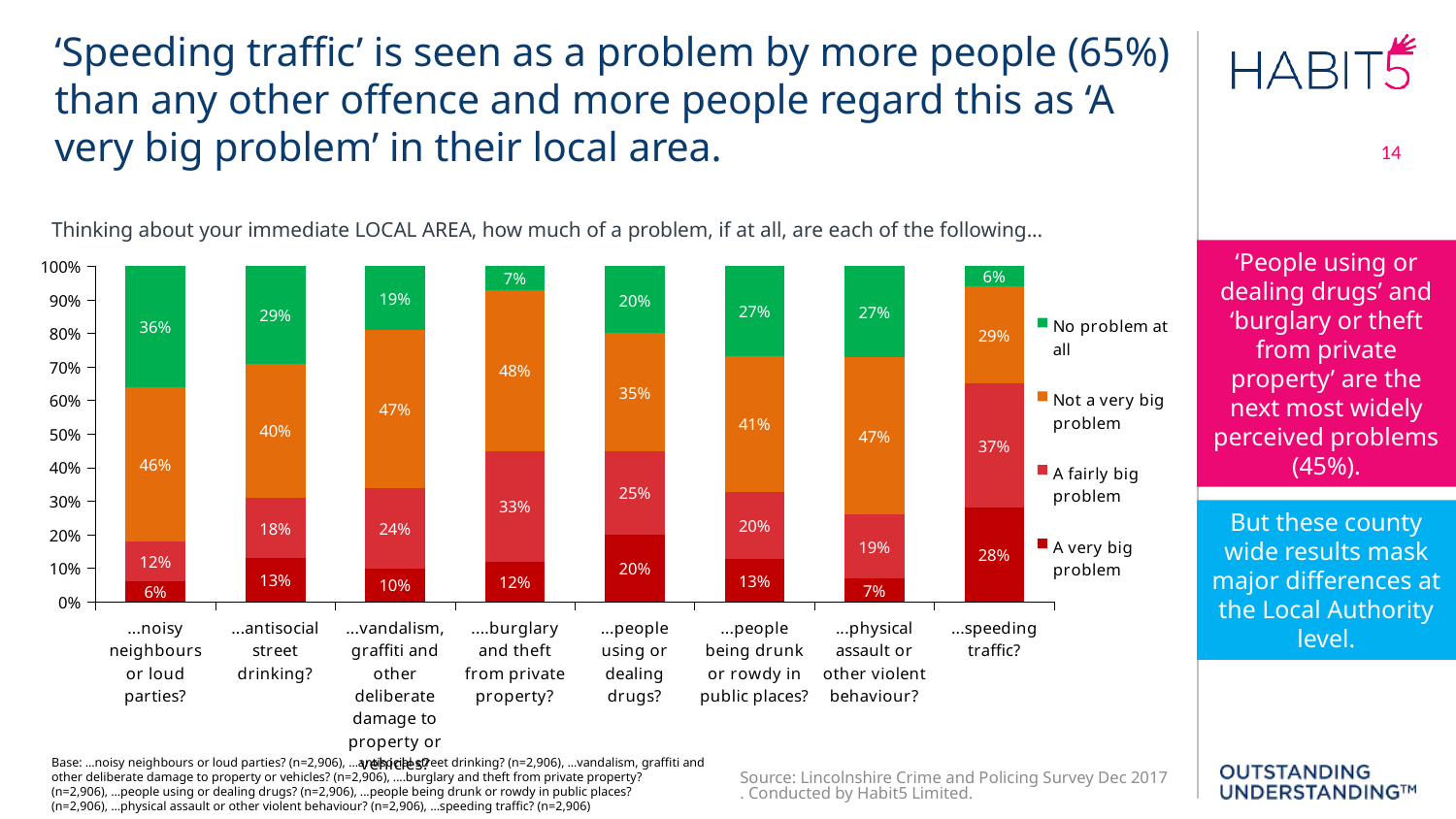
What kind of chart is shown on the slide? Stacked bar chart How many series does the legend list? 4 Which category has the lowest percentage for 'A very big problem'? ...noisy neighbours or loud parties? What is the total of the 'A very big problem' and 'A fairly big problem' segments for physical assault or other violent behaviour? 26% Which category has the highest percentage for 'A very big problem'? ...speeding traffic? What percentage said people using or dealing drugs is 'A fairly big problem'? 25% What percentage said 'No problem at all' for noisy neighbours or loud parties? 36% What is the difference between the 'A very big problem' percentages for speeding traffic and people using or dealing drugs? 8% How many categories are shown on the x axis of the chart? 8 What percentage said burglary and theft from private property is 'Not a very big problem'? 48% What percentage of respondents said speeding traffic is 'A very big problem'? 28% Which is larger: the 'No problem at all' percentage for antisocial street drinking or for vandalism, graffiti and other deliberate damage? ...antisocial street drinking?